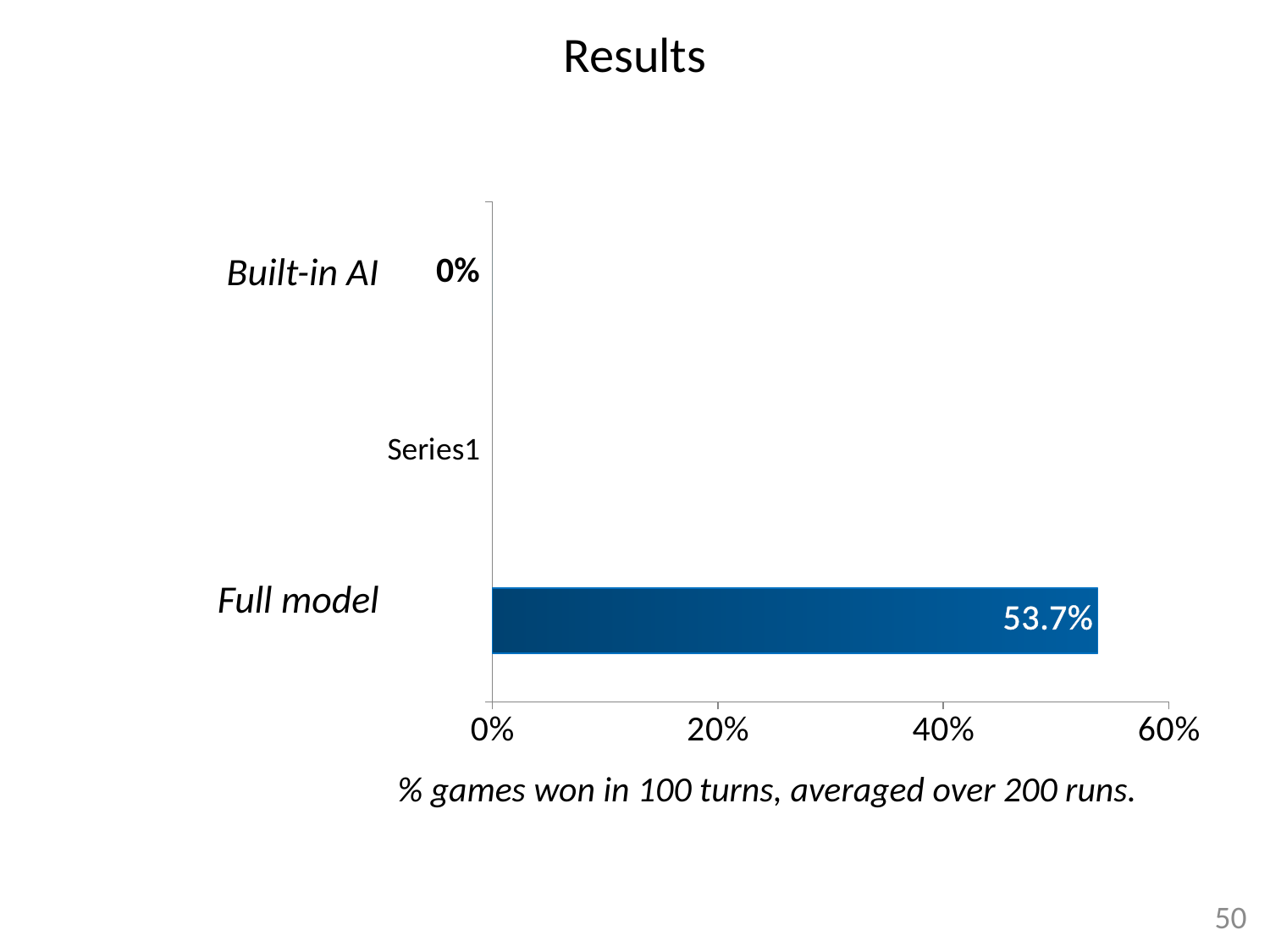
What is the difference between the values for Full model and Built-in AI? 53.7% What is the value for Full model? 53.7% Which is larger, the value for Full model or the value for Built-in AI? Full model Is the value for Full model greater or less than 40%? greater What kind of chart is shown on the slide? bar chart What is the title of the slide? Results Is the value for Full model greater or less than 60%? less Which category has the highest value? Full model What is the value for Built-in AI? 0% How many category labels appear on the vertical axis? 3 Which category has the lowest printed value? Built-in AI What is the label on the horizontal axis? % games won in 100 turns, averaged over 200 runs.